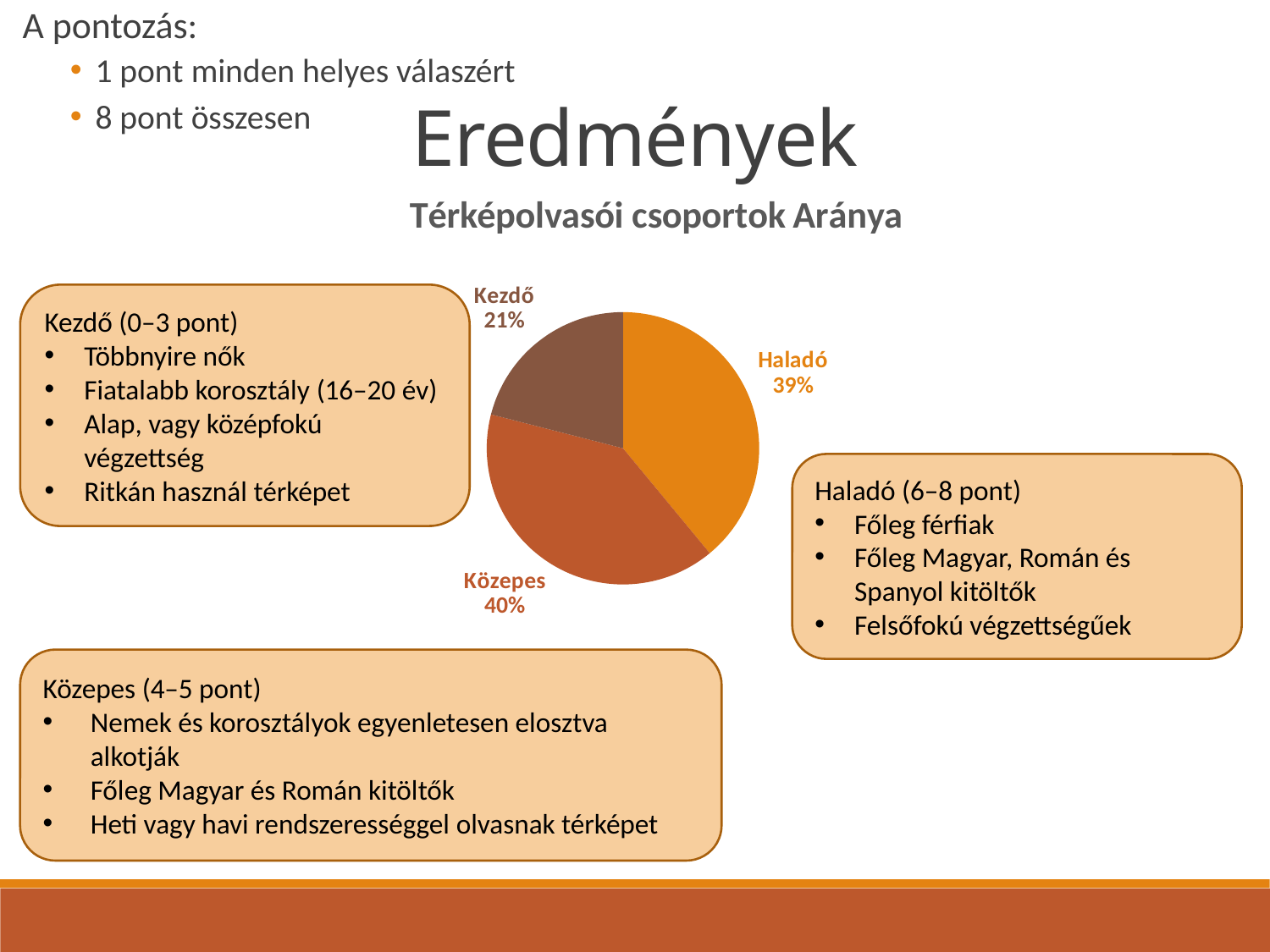
What is the difference between the Haladó share and the Kezdő share? 18% What is the difference between the Közepes share and the Kezdő share? 19% What share of the pie does Közepes have? 40% What is the title of the chart? Térképolvasói csoportok Aránya Which group has the smallest share of the pie? Kezdő What kind of chart is shown on the slide? pie chart How many slices does the pie chart have? 3 What share of the pie does Kezdő have? 21% Which is larger, the share for Haladó or the share for Kezdő? Haladó Which group has the largest share of the pie? Közepes What share of the pie does Haladó have? 39% Which slice of the pie is shown in brown? Kezdő